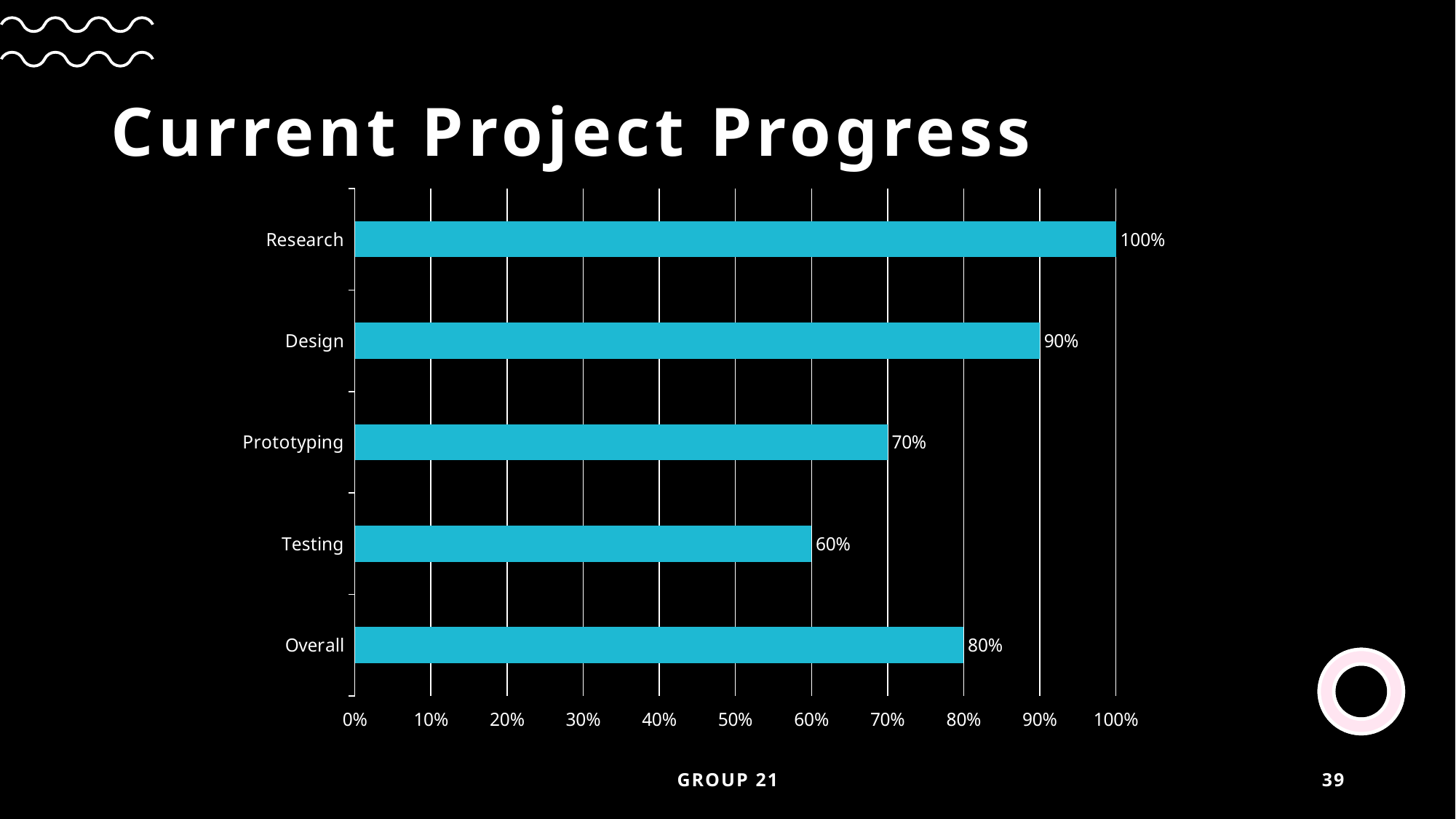
What is the title of the slide? Current Project Progress What is the value for Testing? 60% Which is larger, the value for Prototyping or the value for Overall? Overall What is the difference between the values for Research and Testing? 40% Is the value for Design greater or less than 50%? greater What kind of chart is shown on the slide? bar chart What is the value for Research? 100% Which category has the highest value? Research Which category has the lowest value? Testing What is the value for Overall? 80% What is the difference between the values for Design and Prototyping? 20% How many categories are shown in the chart? 5